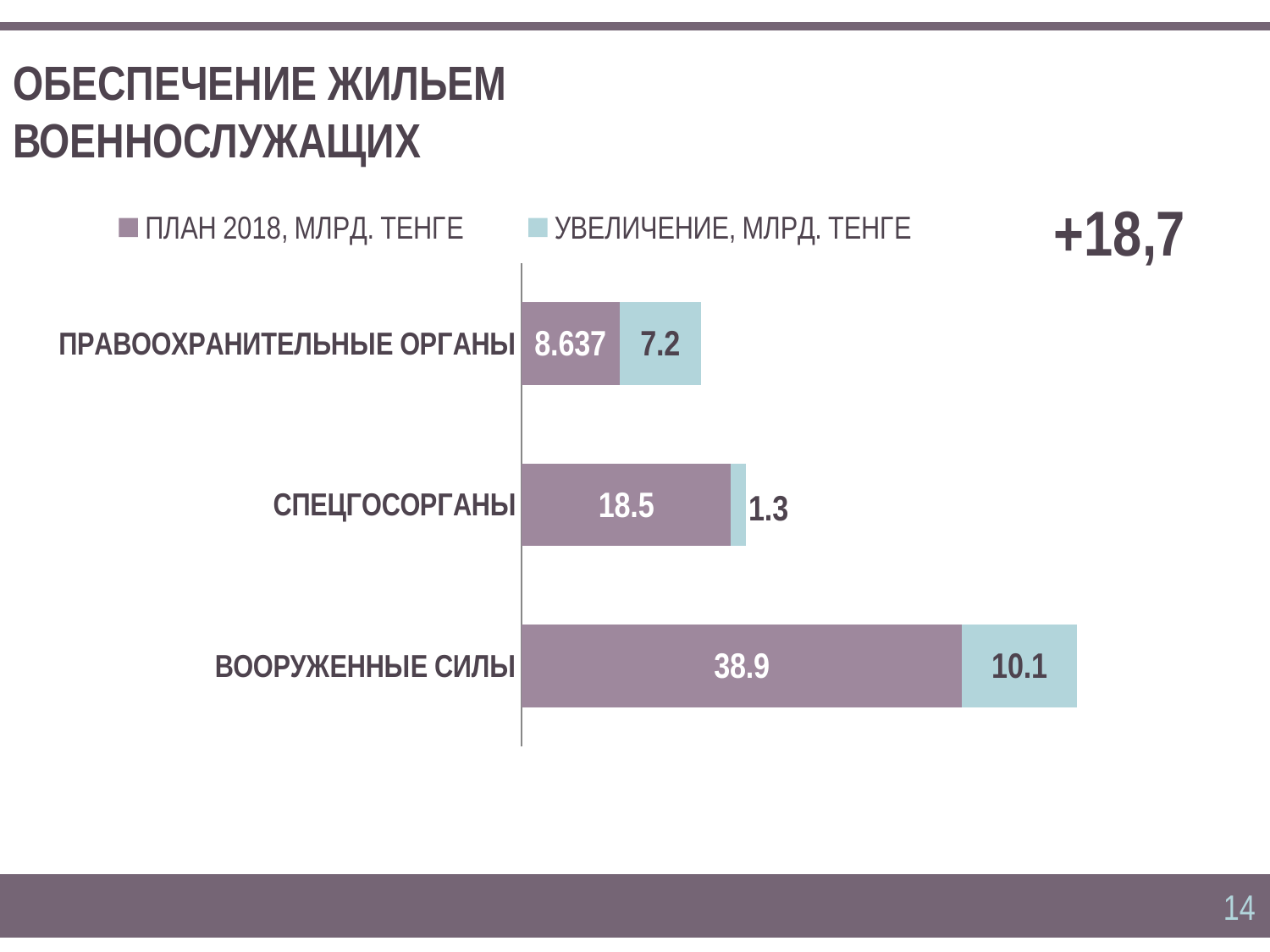
How many categories are shown in the chart? 3 What kind of chart is shown on the slide? Stacked bar chart Which category has the highest ПЛАН 2018, МЛРД. ТЕНГЕ value? ВООРУЖЕННЫЕ СИЛЫ Which category has the lowest УВЕЛИЧЕНИЕ, МЛРД. ТЕНГЕ value? СПЕЦГОСОРГАНЫ What is the difference between the ПЛАН 2018 values for ВООРУЖЕННЫЕ СИЛЫ and СПЕЦГОСОРГАНЫ? 20.4 How many series does the legend list? 2 What is the ПЛАН 2018, МЛРД. ТЕНГЕ value for СПЕЦГОСОРГАНЫ? 18.5 What is the ПЛАН 2018, МЛРД. ТЕНГЕ value for ВООРУЖЕННЫЕ СИЛЫ? 38.9 Which is larger: the УВЕЛИЧЕНИЕ value for ВООРУЖЕННЫЕ СИЛЫ or for ПРАВООХРАНИТЕЛЬНЫЕ ОРГАНЫ? ВООРУЖЕННЫЕ СИЛЫ What is the УВЕЛИЧЕНИЕ, МЛРД. ТЕНГЕ value for ПРАВООХРАНИТЕЛЬНЫЕ ОРГАНЫ? 7.2 What number is shown in large text at the top right of the chart? +18,7 What is the total of the stacked bar for СПЕЦГОСОРГАНЫ? 19.8